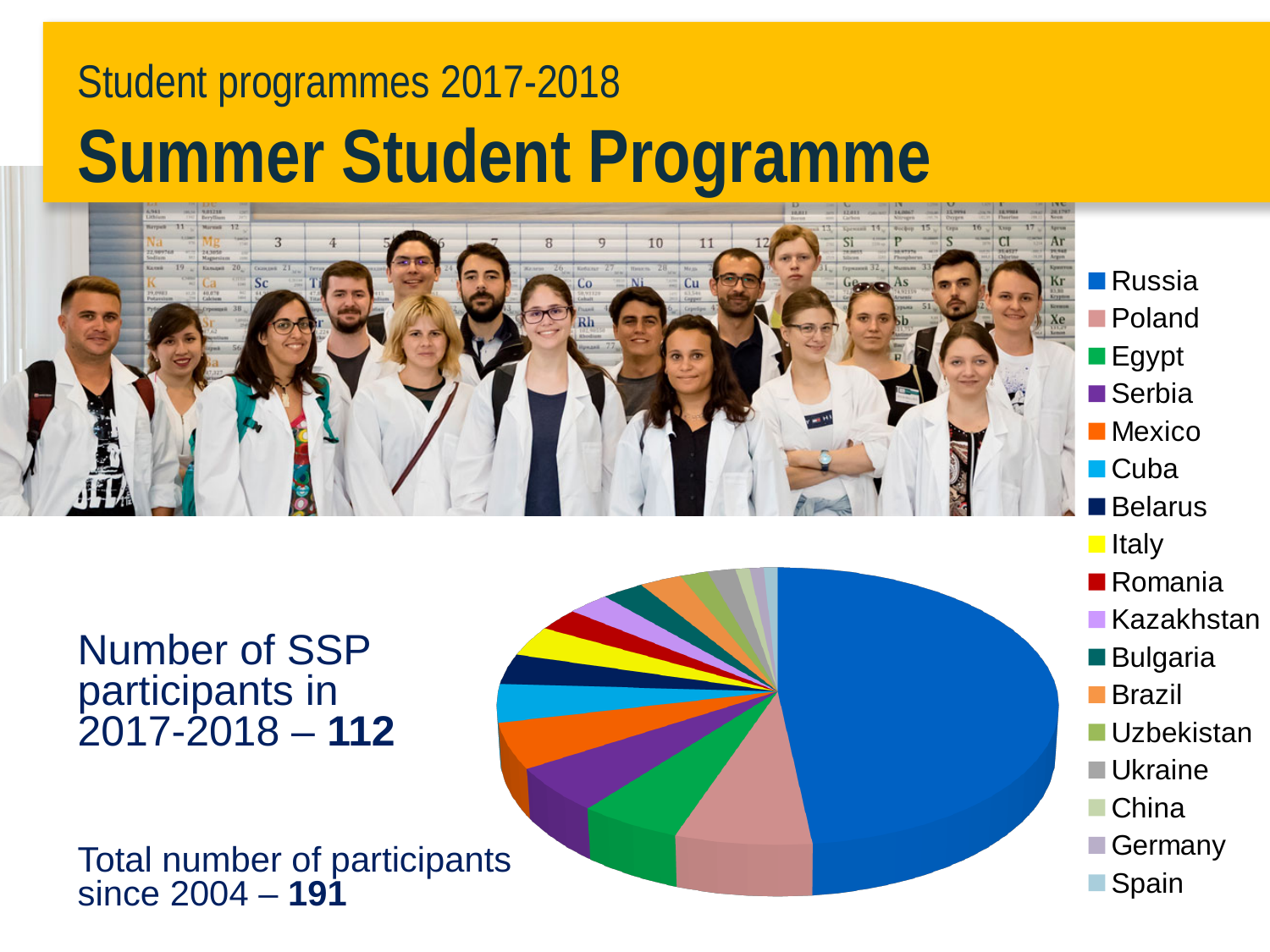
Which slice is larger in the pie chart, Serbia or China? Serbia Which country is listed first in the pie chart's legend? Russia Which country has the largest slice of the pie chart? Russia Which country is listed last in the pie chart's legend? Spain How many countries does the pie chart's legend list? 17 Which slice is larger in the pie chart, Poland or Spain? Poland Which slice is larger in the pie chart, Poland or Egypt? Poland What kind of chart is shown on the slide? pie chart